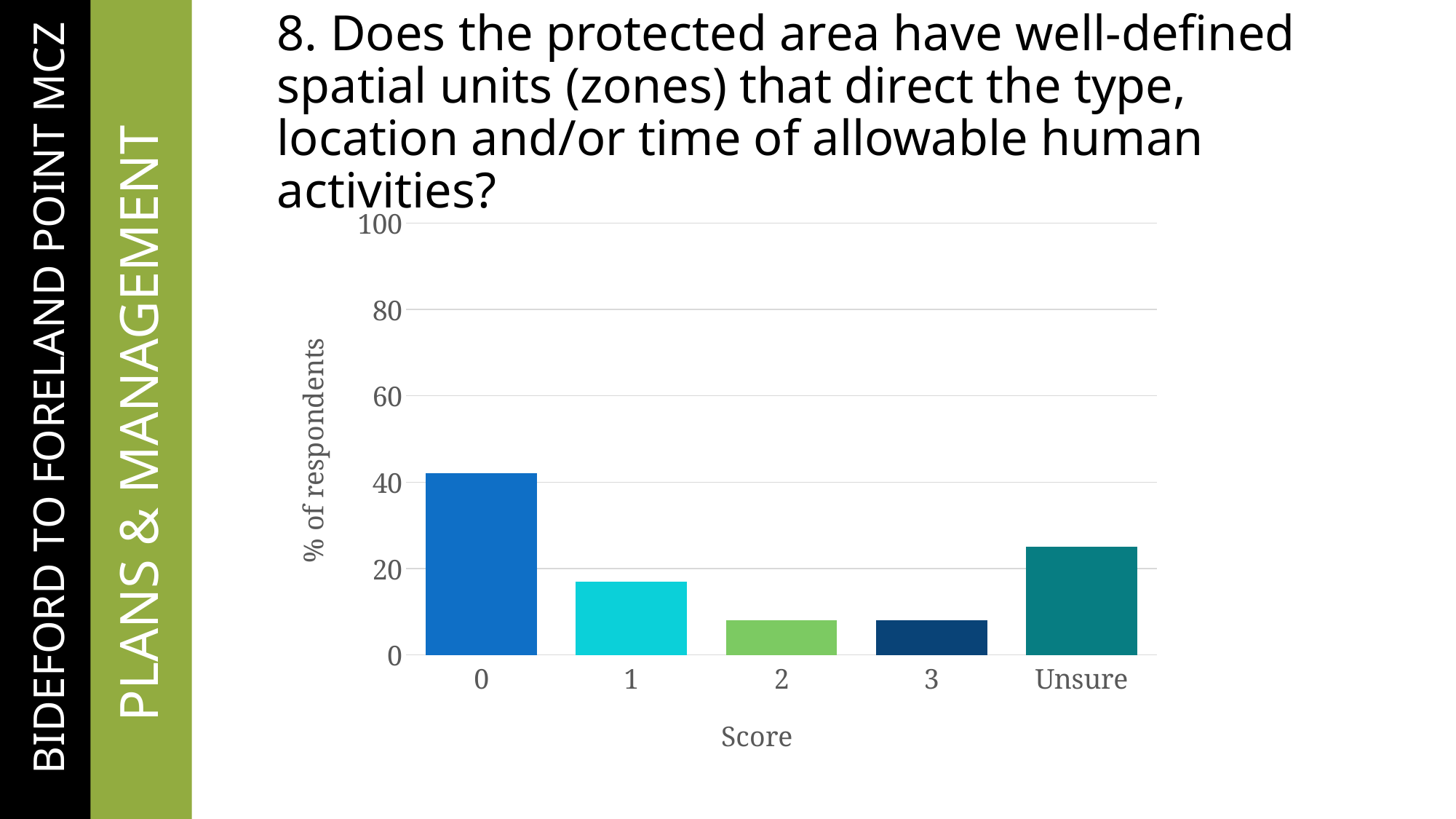
Which score category has the highest percentage of respondents? 0 What kind of chart is shown on the slide? bar chart Is the value for Unsure greater or less than 20? greater Do the values rise or fall as the score goes from 0 to 3? fall What is the label on the y axis? % of respondents Is the value for score 0 greater or less than 60? less Is the value for score 0 greater or less than 20? greater How many score categories are shown on the x axis? 5 Which has a larger percentage of respondents, score 1 or score 2? 1 Which has a larger percentage of respondents, score 0 or Unsure? 0